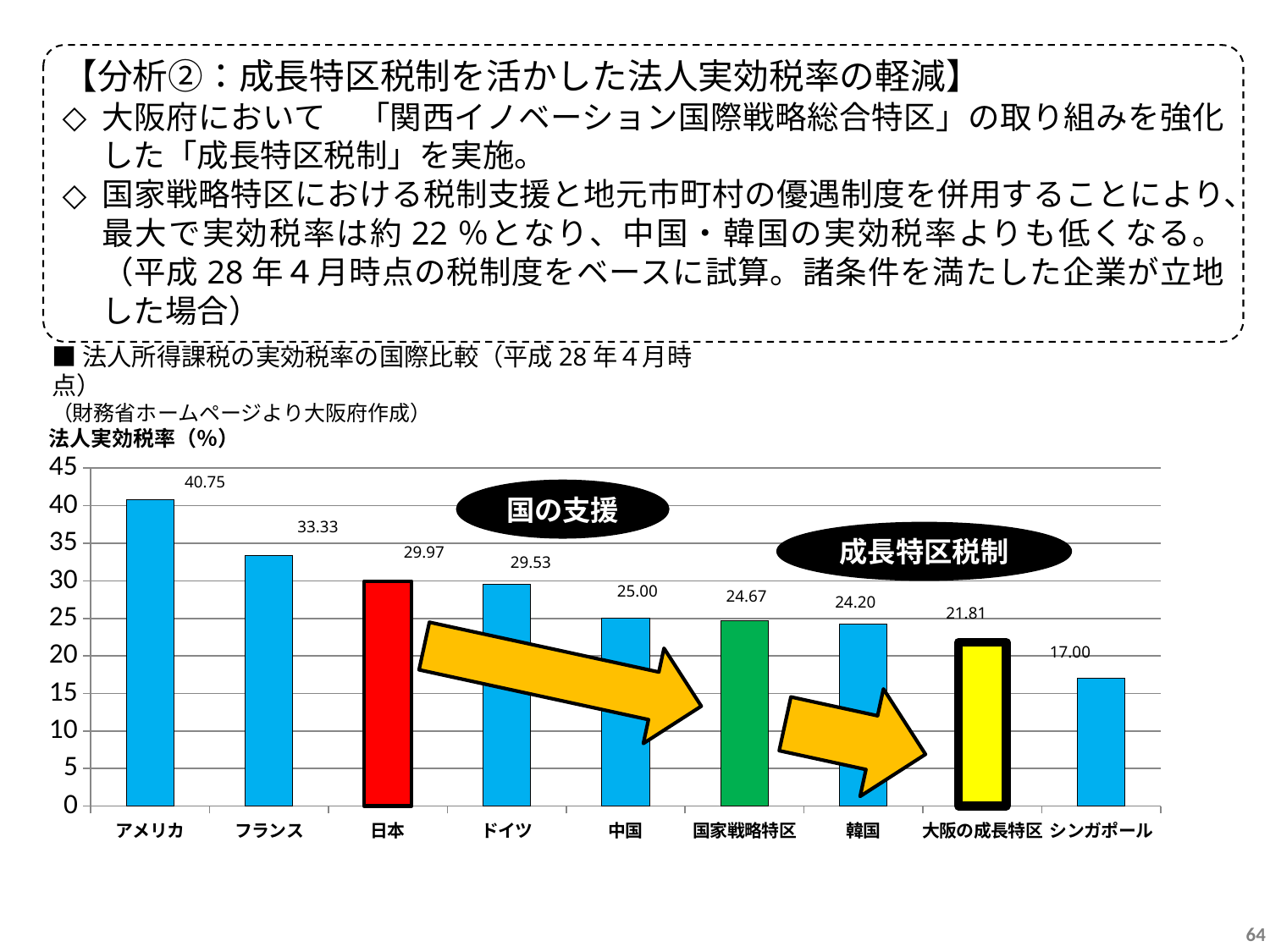
What is the value for 大阪の成長特区? 21.81 What kind of chart is this? bar chart Is the value for フランス greater or less than 30? greater How many categories are shown on the x axis? 9 What is the value for 国家戦略特区? 24.67 What is the difference between the values for 日本 and 大阪の成長特区? 8.16 What colour is the bar for 日本? red What is the value for アメリカ? 40.75 Which category has the lowest value? シンガポール Which category has the highest value? アメリカ Do the values generally rise or fall from left to right along the x axis? fall Which is larger, the value for 中国 or the value for 韓国? 中国